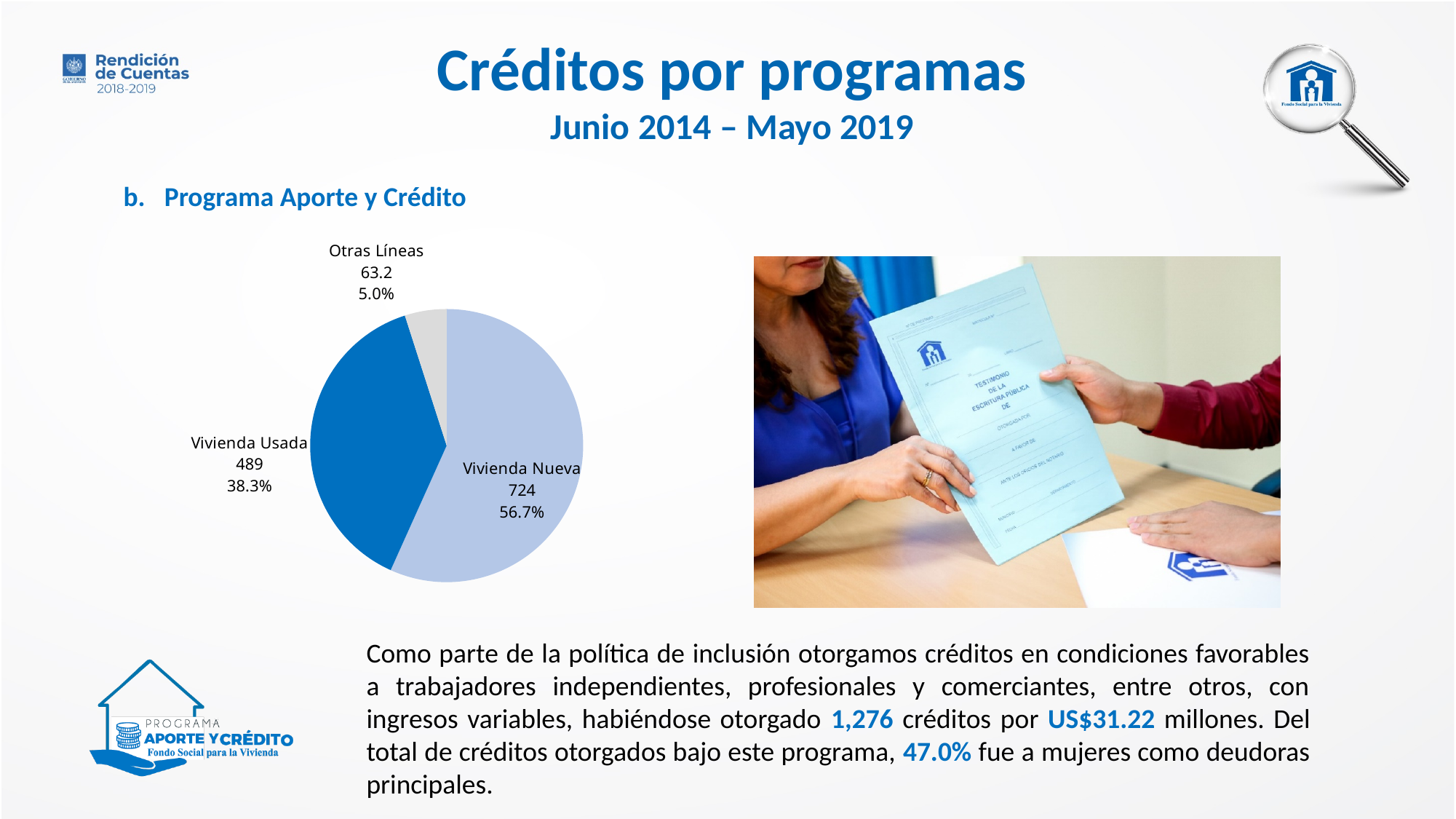
What is the value shown for Vivienda Usada? 489 What share of the pie does Vivienda Usada represent? 38.3% Which category has the largest slice of the pie? Vivienda Nueva Which is larger, the value for Vivienda Usada or the value for Otras Líneas? Vivienda Usada What share of the pie does Otras Líneas represent? 5.0% What is the value shown for Vivienda Nueva? 724 What is the value shown for Otras Líneas? 63.2 Which category has the smallest slice of the pie? Otras Líneas What is the difference between the values for Vivienda Nueva and Vivienda Usada? 235 What kind of chart is shown on the slide? pie chart What share of the pie does Vivienda Nueva represent? 56.7% How many slices does the pie chart have? 3